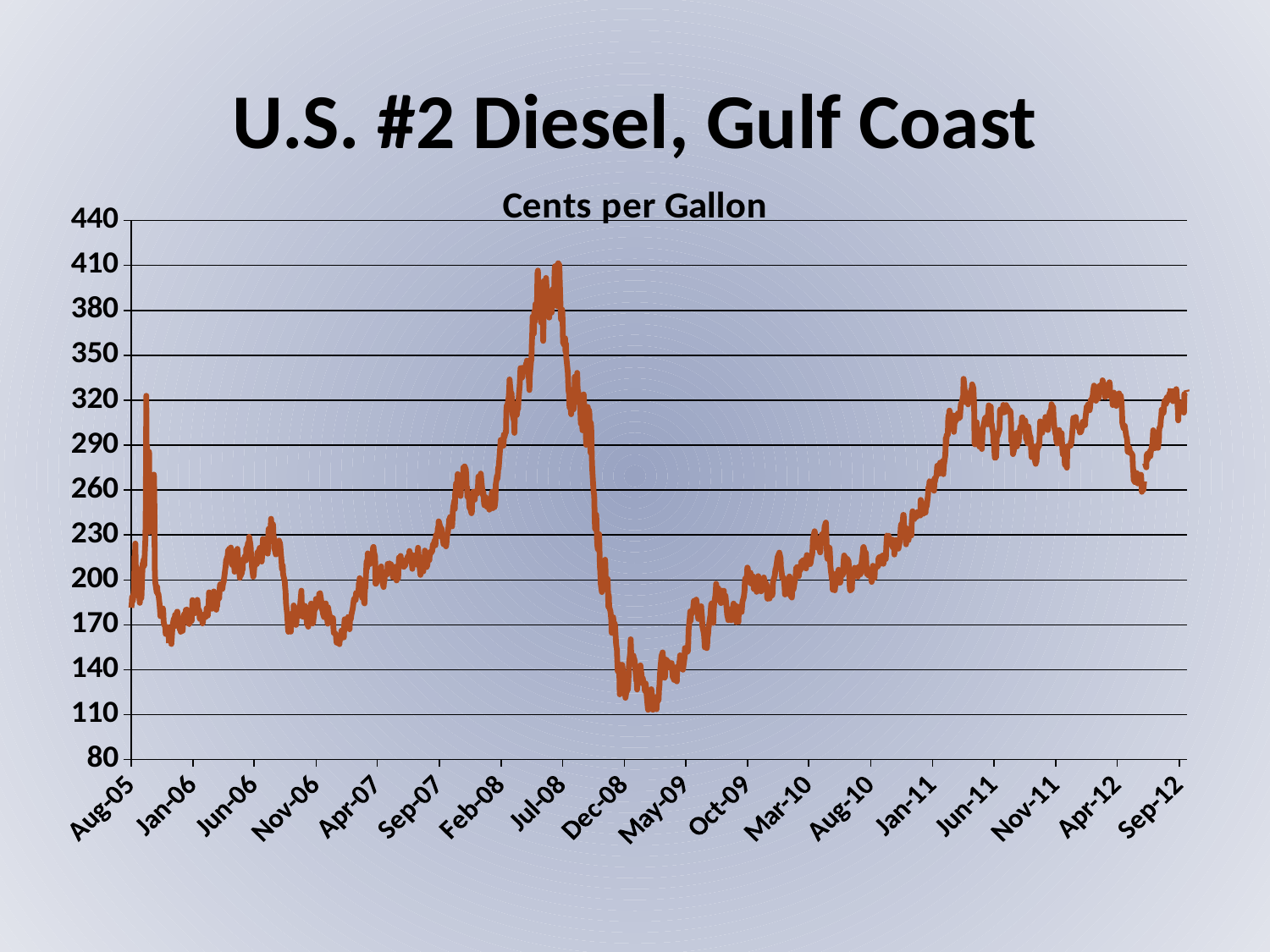
Does the line rise or fall between Jul-08 and Dec-08? fall Near which x-axis label does the line reach its highest point? Jul-08 How many date labels are shown along the x axis? 18 Is the value at Jan-11 greater or less than 260? less What is the title of the chart? U.S. #2 Diesel, Gulf Coast Is the lowest value on the chart, reached between Dec-08 and May-09, greater or less than 140? less What kind of chart is shown on the slide? line chart What unit is shown above the y axis of the chart? Cents per Gallon Is the value at Sep-12 greater or less than 290? greater Which is larger, the value at Jul-08 or the value at Dec-08? Jul-08 Does the line rise or fall between May-09 and Jan-11? rise